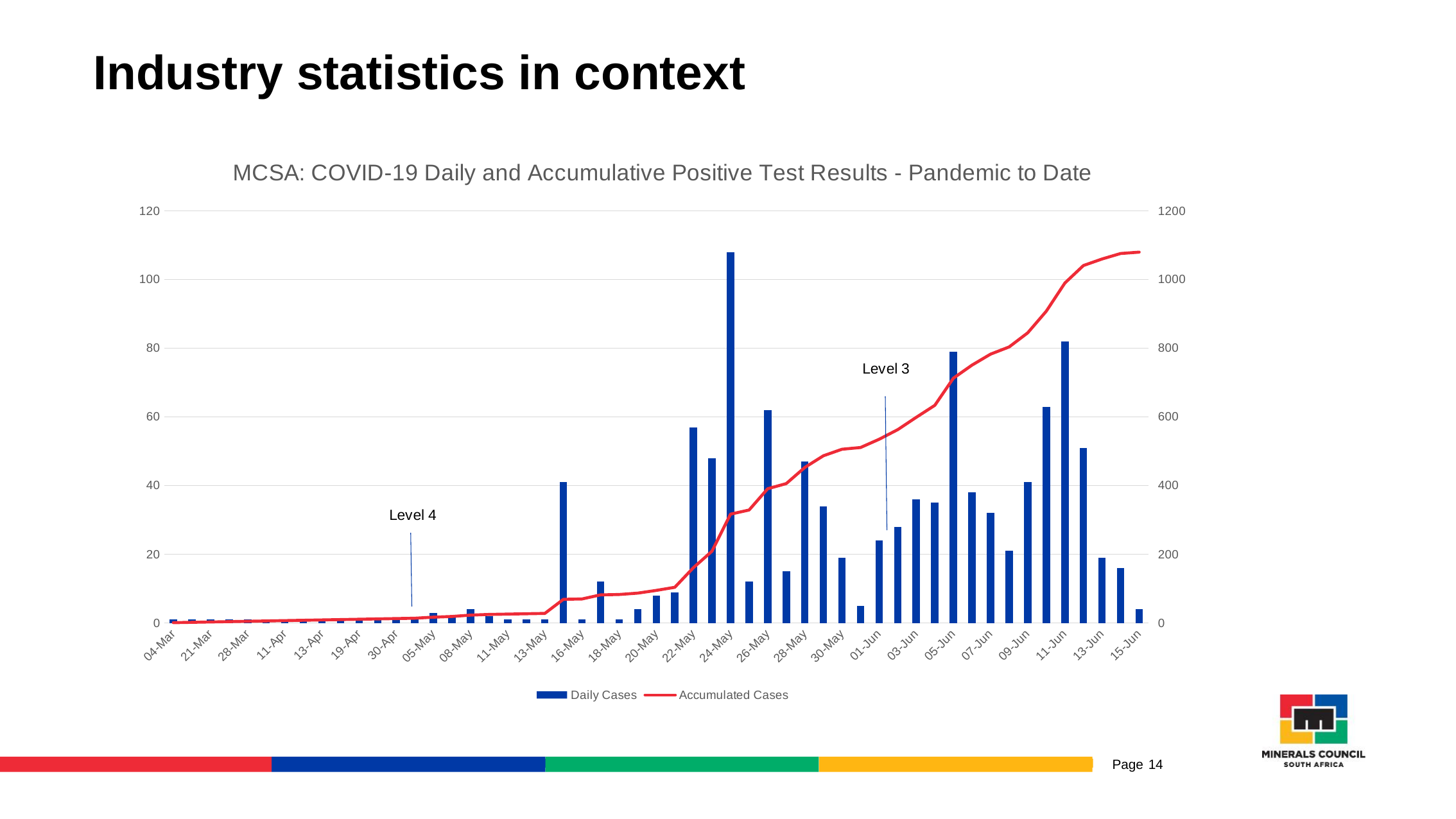
How many series does the legend list? 2 Does the Accumulated Cases line rise or fall from 04-Mar to 15-Jun? rise Which series is drawn as a red line? Accumulated Cases On which date is the Daily Cases bar the highest? 24-May Is the Accumulated Cases value on 15-Jun greater or less than 1000? greater What is the title of the chart? MCSA: COVID-19 Daily and Accumulative Positive Test Results - Pandemic to Date Is the Daily Cases value for 13-May greater or less than 20? less Is the Accumulated Cases value on 13-May greater or less than 200? less Which date has more Daily Cases, 24-May or 05-Jun? 24-May What kind of chart is shown on the slide? A combined bar and line chart